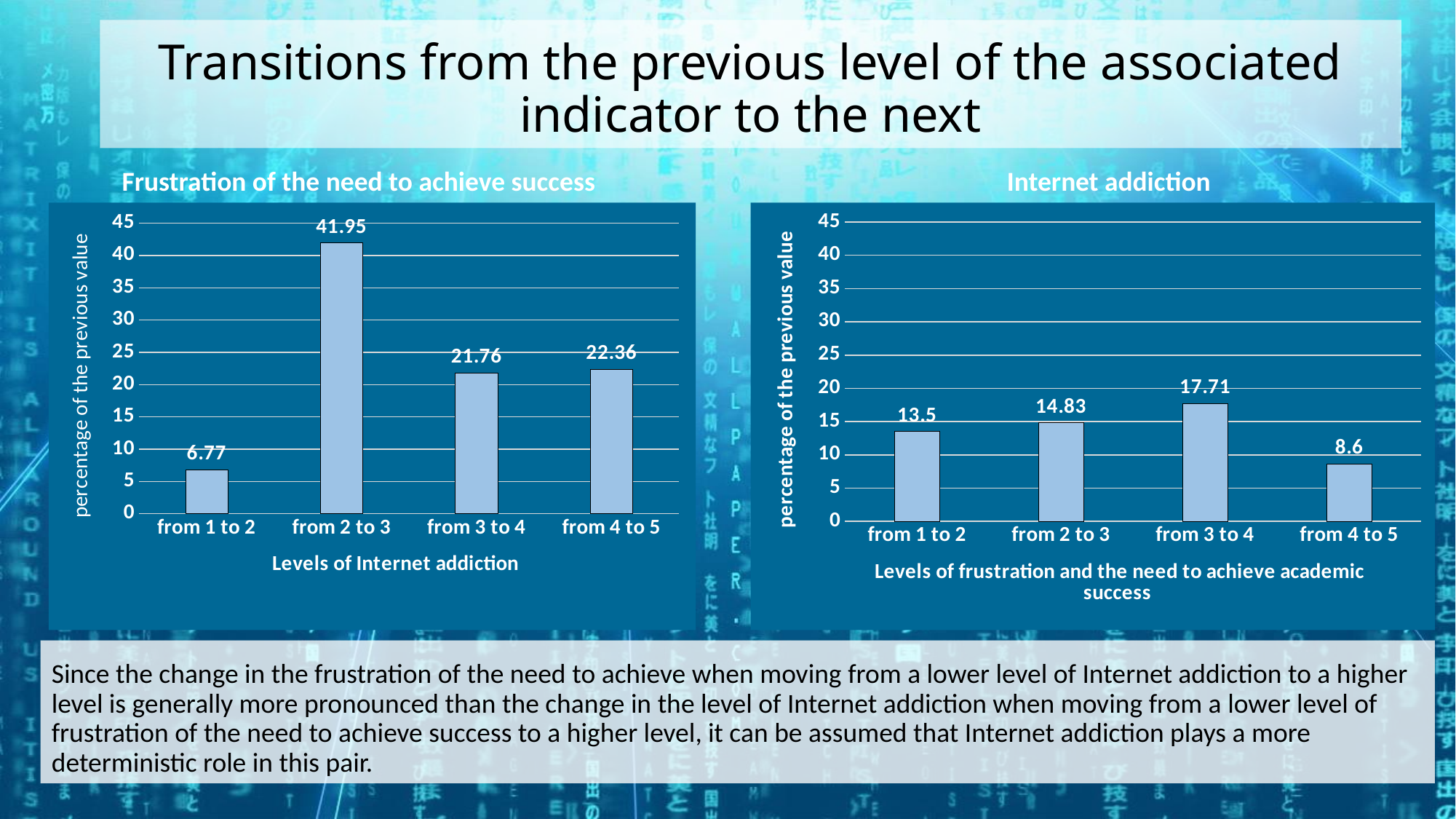
In the 'Internet addiction' chart, is the value for 'from 2 to 3' greater or less than 10? greater What kind of chart is the 'Frustration of the need to achieve success' chart? bar chart In the 'Frustration of the need to achieve success' chart, which category has the lowest value? from 1 to 2 In the 'Internet addiction' chart, which category has the highest value? from 3 to 4 How many categories are shown on the x axis of the 'Internet addiction' chart? 4 What is the y-axis title of the 'Internet addiction' chart? percentage of the previous value What is the x-axis title of the 'Frustration of the need to achieve success' chart? Levels of Internet addiction In the 'Frustration of the need to achieve success' chart, what is the difference between the values for 'from 2 to 3' and 'from 1 to 2'? 35.18 In the 'Frustration of the need to achieve success' chart, what is the value for 'from 2 to 3'? 41.95 In the 'Frustration of the need to achieve success' chart, which is larger: the value for 'from 3 to 4' or 'from 4 to 5'? from 4 to 5 In the 'Internet addiction' chart, what is the difference between the values for 'from 3 to 4' and 'from 1 to 2'? 4.21 In the 'Internet addiction' chart, what is the value for 'from 4 to 5'? 8.6